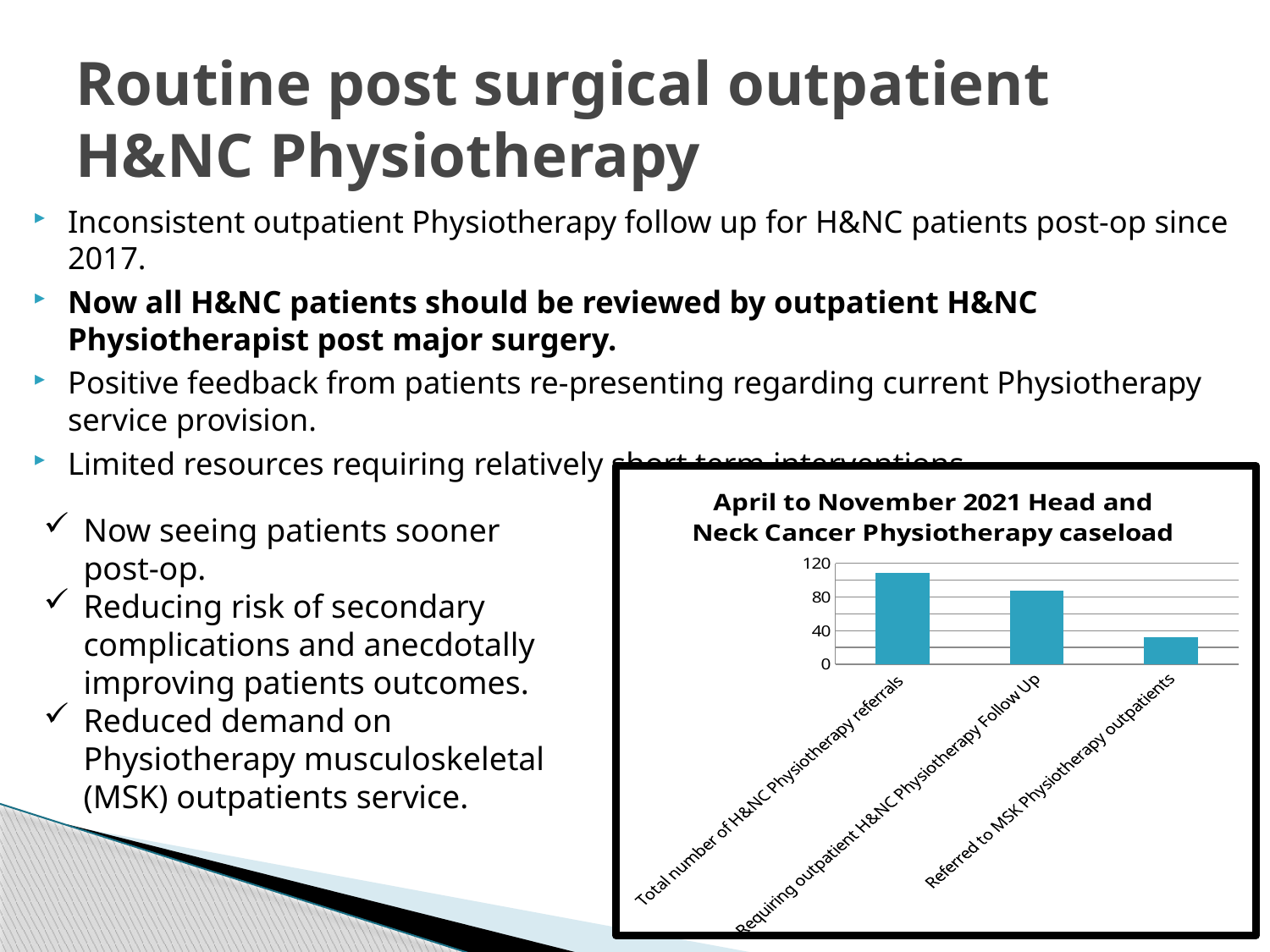
Which is larger: Requiring outpatient H&NC Physiotherapy Follow Up or Referred to MSK Physiotherapy outpatients? Requiring outpatient H&NC Physiotherapy Follow Up Which category has the highest value? Total number of H&NC Physiotherapy referrals Is the value for Referred to MSK Physiotherapy outpatients greater or less than 80? less What is the highest tick value shown on the vertical axis? 120 What is the title of the chart? April to November 2021 Head and Neck Cancer Physiotherapy caseload How many categories are plotted in the chart? 3 Is the value for Requiring outpatient H&NC Physiotherapy Follow Up greater or less than 40? greater What type of chart is shown on the slide? bar chart Is the value for Total number of H&NC Physiotherapy referrals greater or less than 120? less Which category has the lowest value? Referred to MSK Physiotherapy outpatients Do the values rise or fall from left to right across the categories? fall